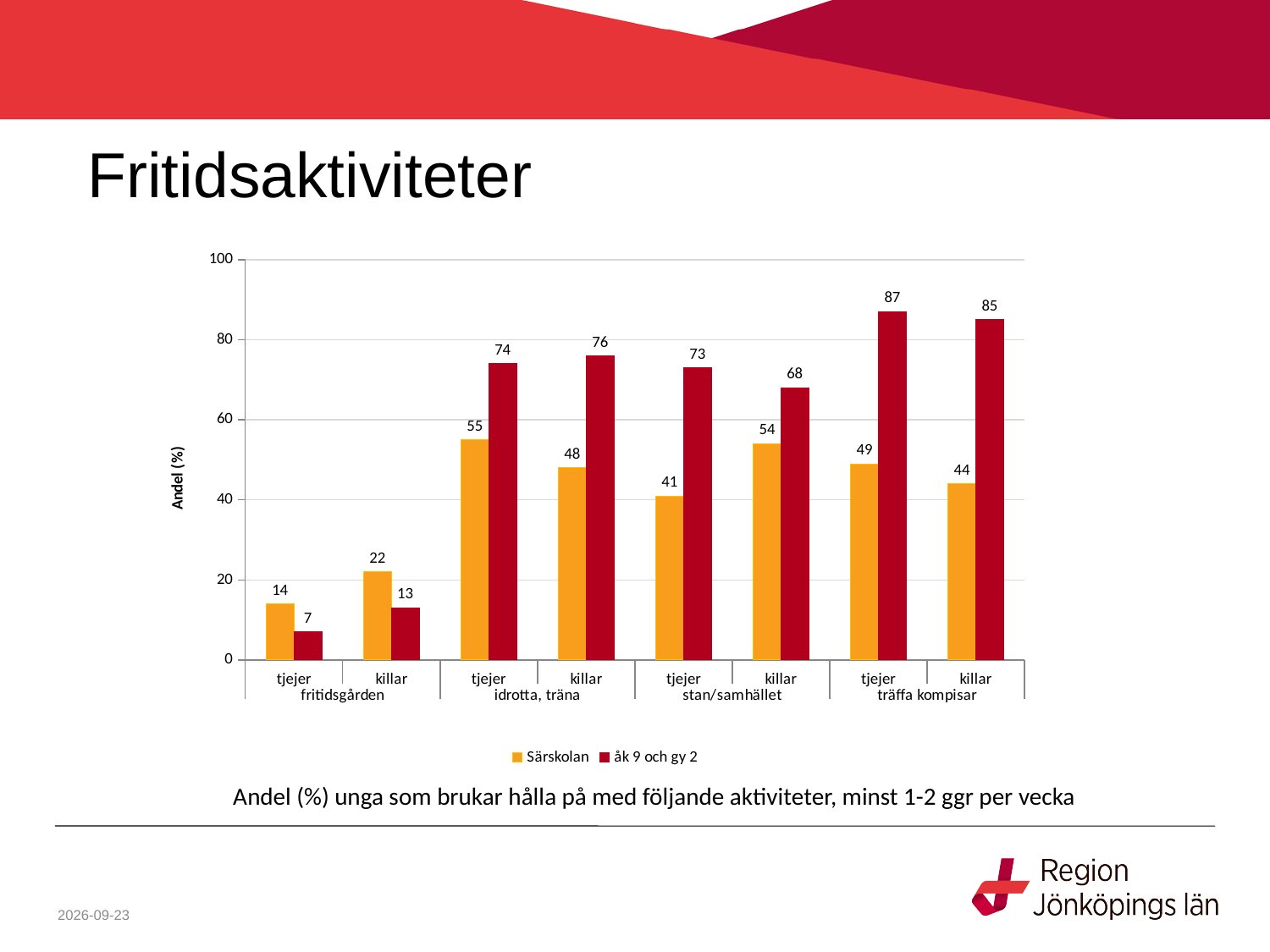
What kind of chart is shown on the slide? bar chart Which category has the lowest value for the Särskolan series? tjejer, fritidsgården What is the value for åk 9 och gy 2 for killar in the träffa kompisar group? 85 How many activity groups are shown on the x axis? 4 For killar in the fritidsgården group, which series has the larger value, Särskolan or åk 9 och gy 2? Särskolan What is the difference between the åk 9 och gy 2 value and the Särskolan value for tjejer in the idrotta, träna group? 19 What is the label of the y axis? Andel (%) How many series does the legend list? 2 Is the Särskolan value for tjejer in the stan/samhället group greater or less than 60? less What is the value for Särskolan for killar in the stan/samhället group? 54 Which category has the highest value for the åk 9 och gy 2 series? tjejer, träffa kompisar What is the value for Särskolan for tjejer in the fritidsgården group? 14